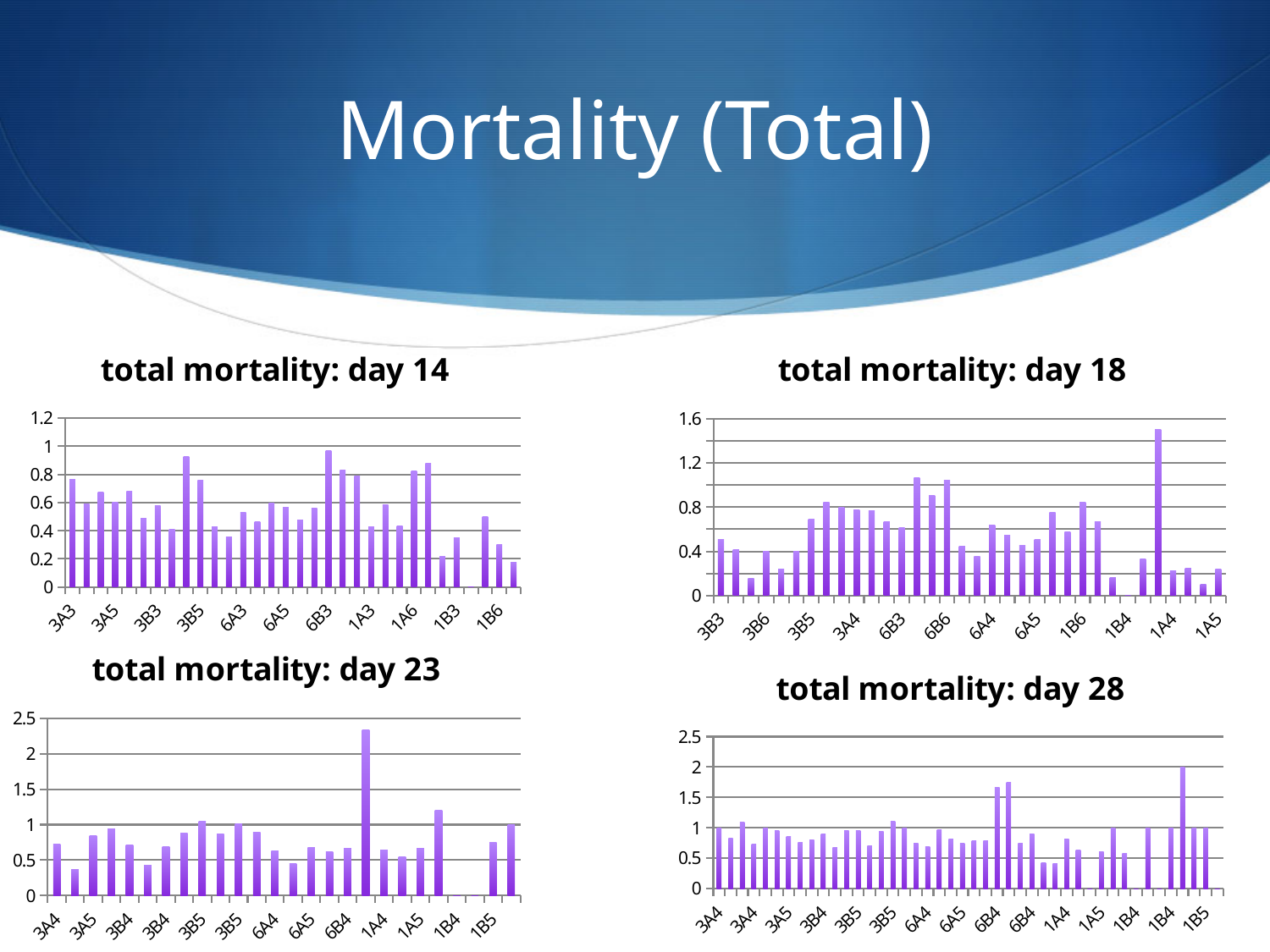
In the "total mortality: day 28" chart, is the tallest bar's value greater or less than 1.5? greater In the "total mortality: day 28" chart, is the value for 3A4 greater or less than 0.5? greater In the "total mortality: day 18" chart, is the tallest bar's value greater or less than 1.2? greater What kind of chart is "total mortality: day 28"? bar chart What is the title of the chart in the bottom-right of the slide? total mortality: day 28 How many charts are shown on the slide? 4 What kind of chart is "total mortality: day 14"? bar chart